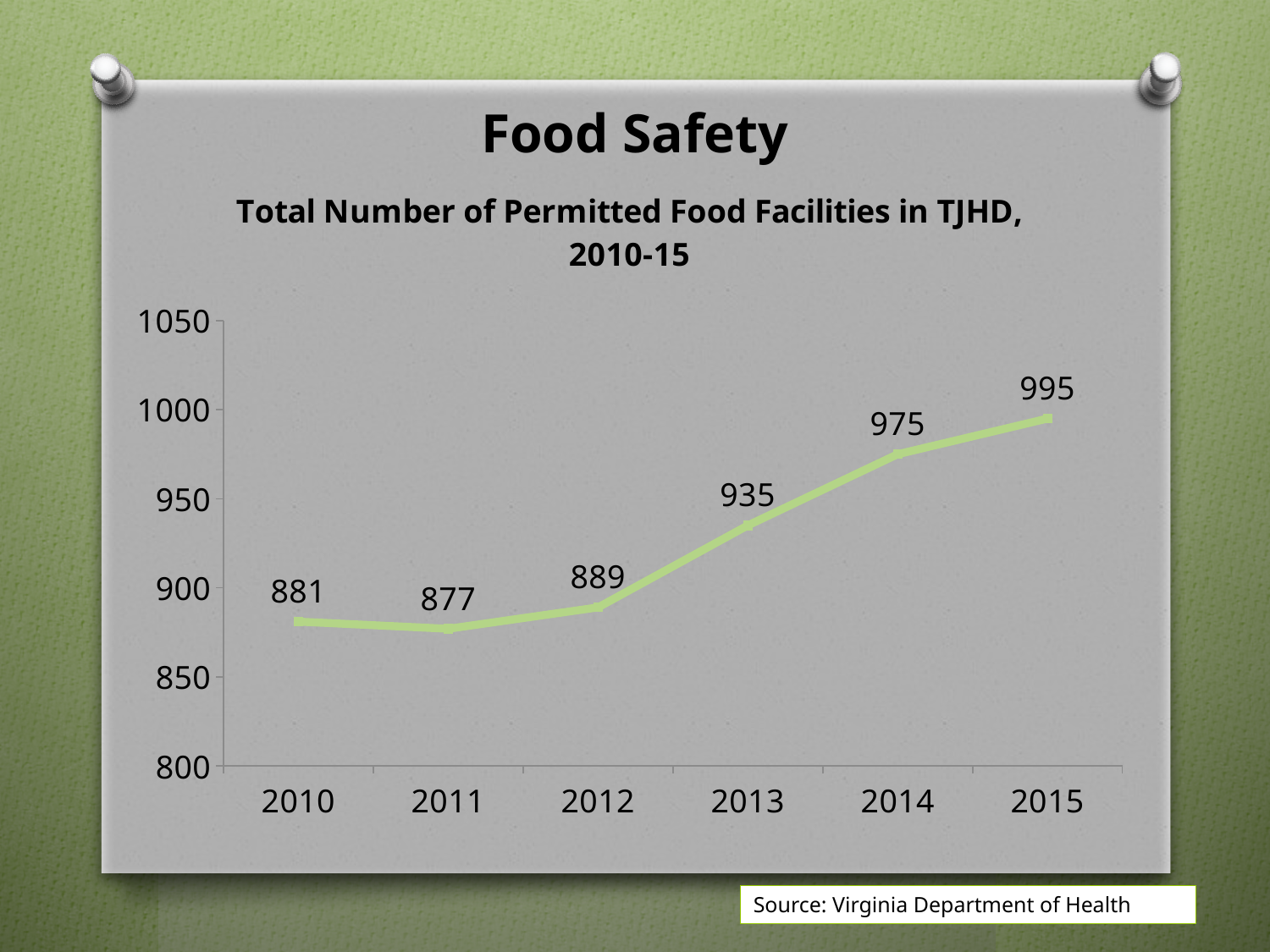
Is the value for 2014 greater or less than 950? greater Which year has a larger value, 2012 or 2014? 2014 What kind of chart is shown on the slide? Line chart What is the value shown for 2015? 995 What is the title of the chart? Total Number of Permitted Food Facilities in TJHD, 2010-15 Which year has the lowest number of permitted food facilities? 2011 By how much did the number of permitted food facilities increase from 2013 to 2014? 40 What is the total number of permitted food facilities in TJHD in 2013? 935 What is the value shown for 2010? 881 How many years are plotted on the chart? 6 Which year has the highest number of permitted food facilities? 2015 What is the difference between the values for 2015 and 2010? 114